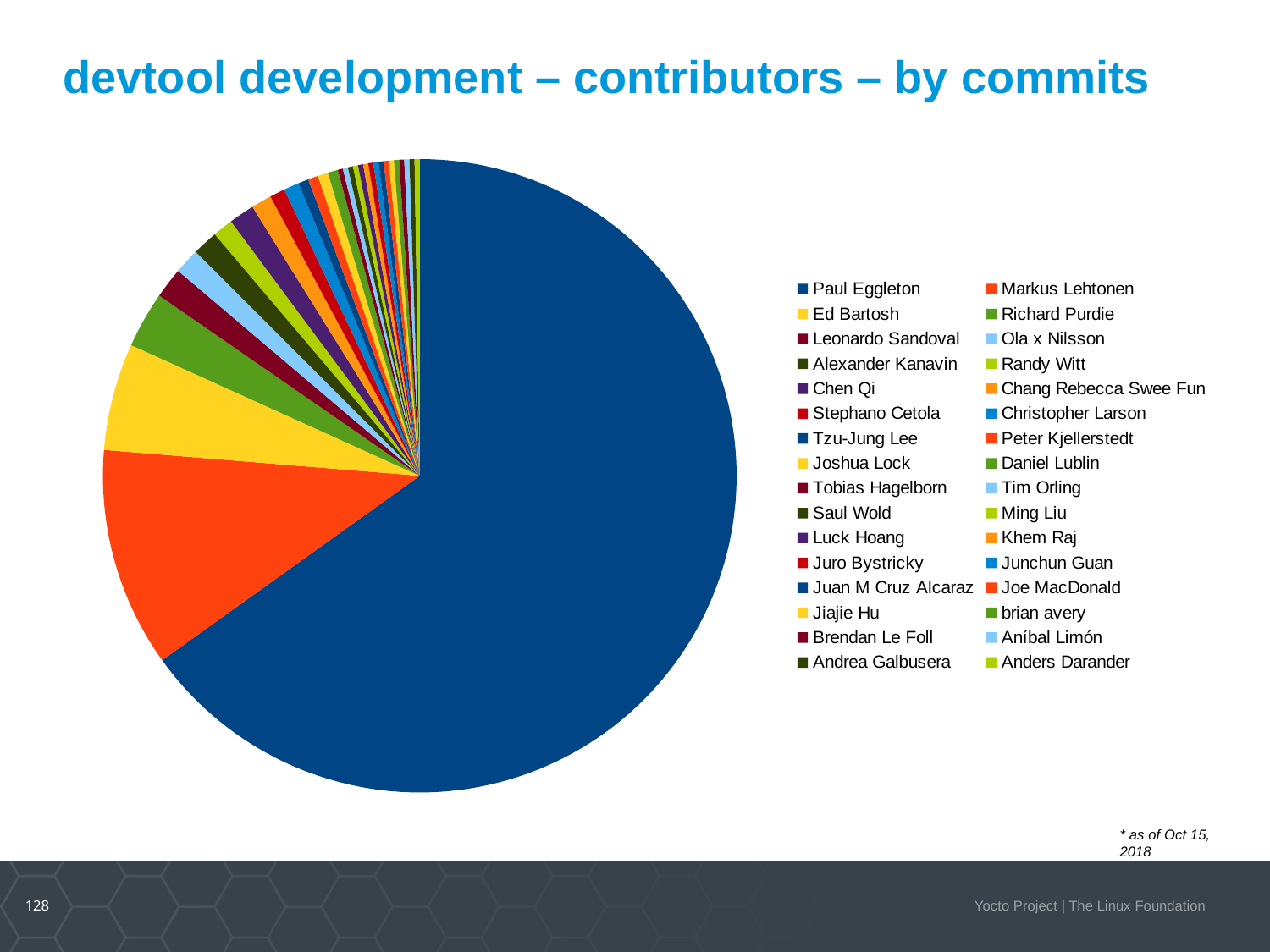
Which contributor has the second-largest slice of the pie? Markus Lehtonen Does Paul Eggleton's slice account for more or less than half of the pie? more What is the title of the slide containing the pie chart? devtool development – contributors – by commits Which slice is larger, Markus Lehtonen's or Ed Bartosh's? Markus Lehtonen As of what date is the data in the chart, according to the footnote? Oct 15, 2018 Which contributor has the largest slice of the pie? Paul Eggleton Which slice is larger, Paul Eggleton's or Markus Lehtonen's? Paul Eggleton Which slice is larger, Ed Bartosh's or Richard Purdie's? Ed Bartosh How many contributors are listed in the legend? 32 What kind of chart is shown on the slide? pie chart